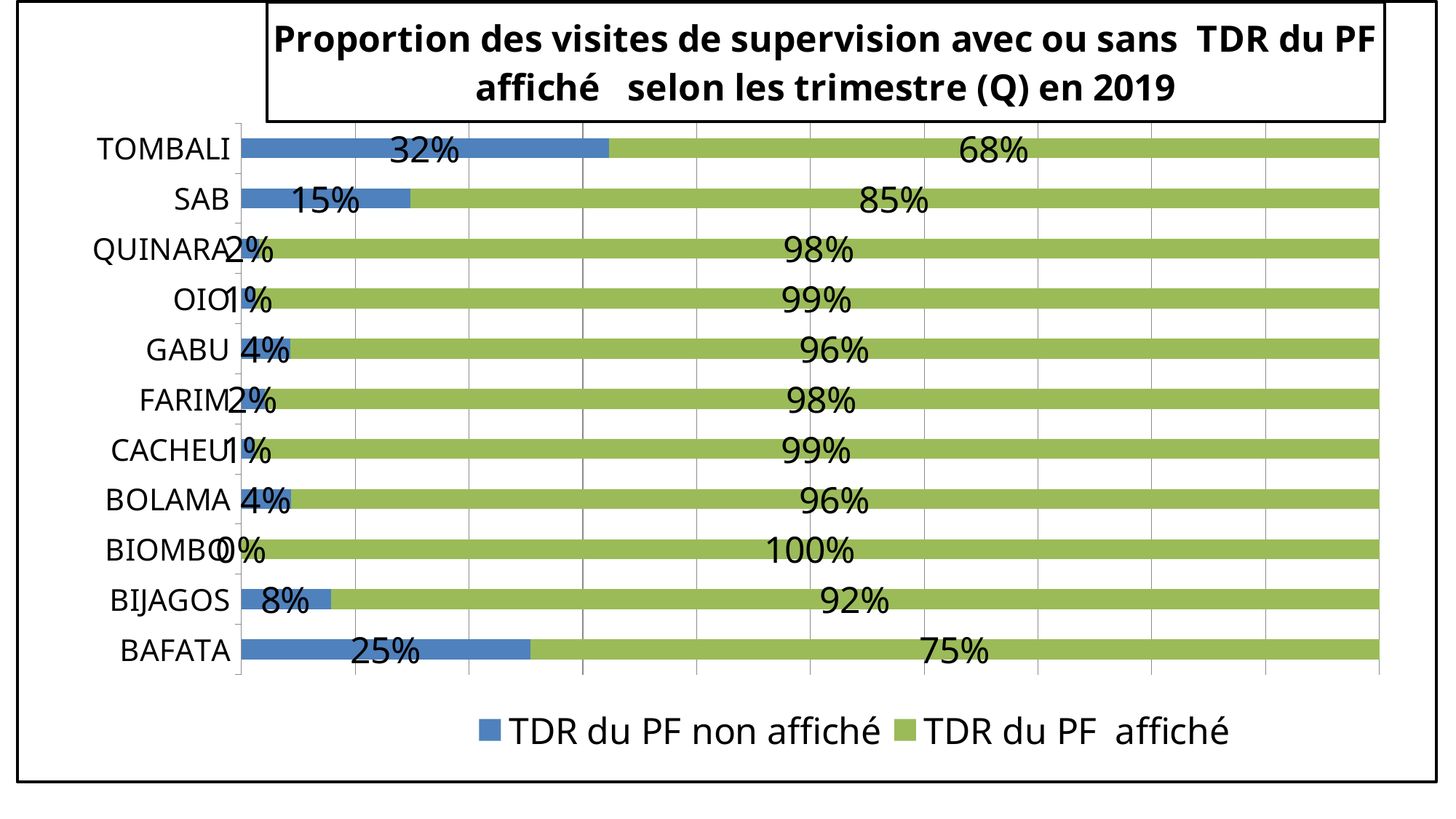
What is the difference between the 'TDR du PF non affiché' values for BAFATA and SAB? 10% Which region has the lowest value for 'TDR du PF affiché'? TOMBALI Which is larger: the 'TDR du PF non affiché' value for BIJAGOS or for GABU? BIJAGOS Which region has a 'TDR du PF affiché' value of 100%? BIOMBO What type of chart is shown on the slide? Stacked bar chart What is the total of the stacked bar for BAFATA? 100% What is the value of 'TDR du PF affiché' for SAB? 85% What is the value of 'TDR du PF non affiché' for TOMBALI? 32% How many regions (categories) are shown on the chart? 11 Which region has the highest value for 'TDR du PF non affiché'? TOMBALI How many series does the legend list? 2 What is the value of 'TDR du PF affiché' for BIJAGOS? 92%